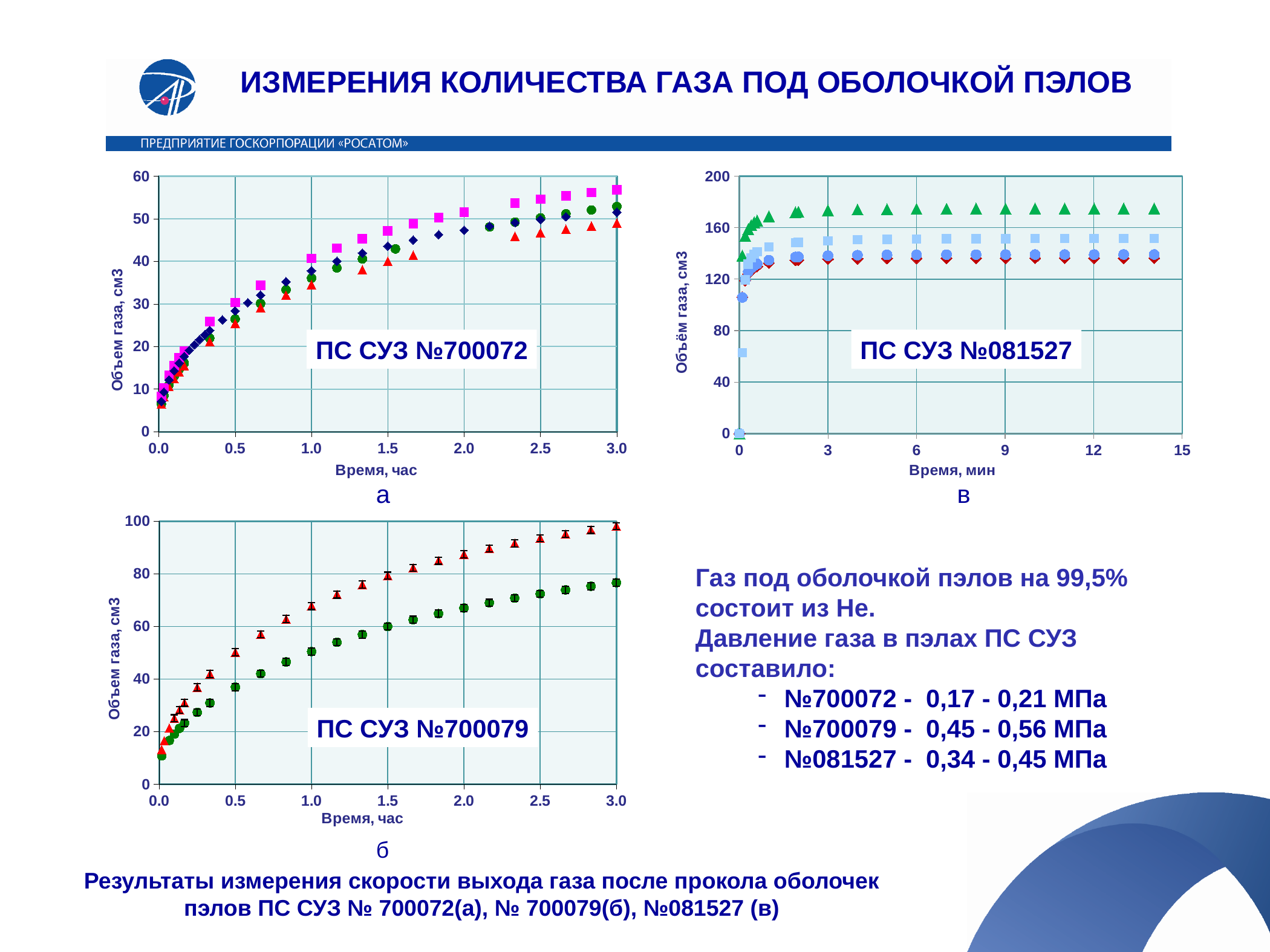
What is the y-axis label of the chart ПС СУЗ №700072 (a)? Объем газа, см3 In the chart ПС СУЗ №081527 (в), which marker series reaches the highest values? green triangles In the chart ПС СУЗ №081527 (в), is the plateau value of the red diamond series greater or less than 160? less How many distinct marker series are plotted in the chart ПС СУЗ №700079 (б)? 2 In the chart ПС СУЗ №700072 (a), is the value of the magenta square series at 3.0 hours greater or less than 50? greater In the chart ПС СУЗ №700079 (б), is the value of the red triangle series at 3.0 hours greater or less than 80? greater What kind of chart is the chart labelled ПС СУЗ №700072 (a)? scatter chart In the chart ПС СУЗ №700079 (б), do the plotted values rise or fall as time increases? rise What is the x-axis label of the chart ПС СУЗ №081527 (в)? Время, мин In the chart ПС СУЗ №700079 (б), which series is higher at 3.0 hours, the red triangles or the green circles? red triangles